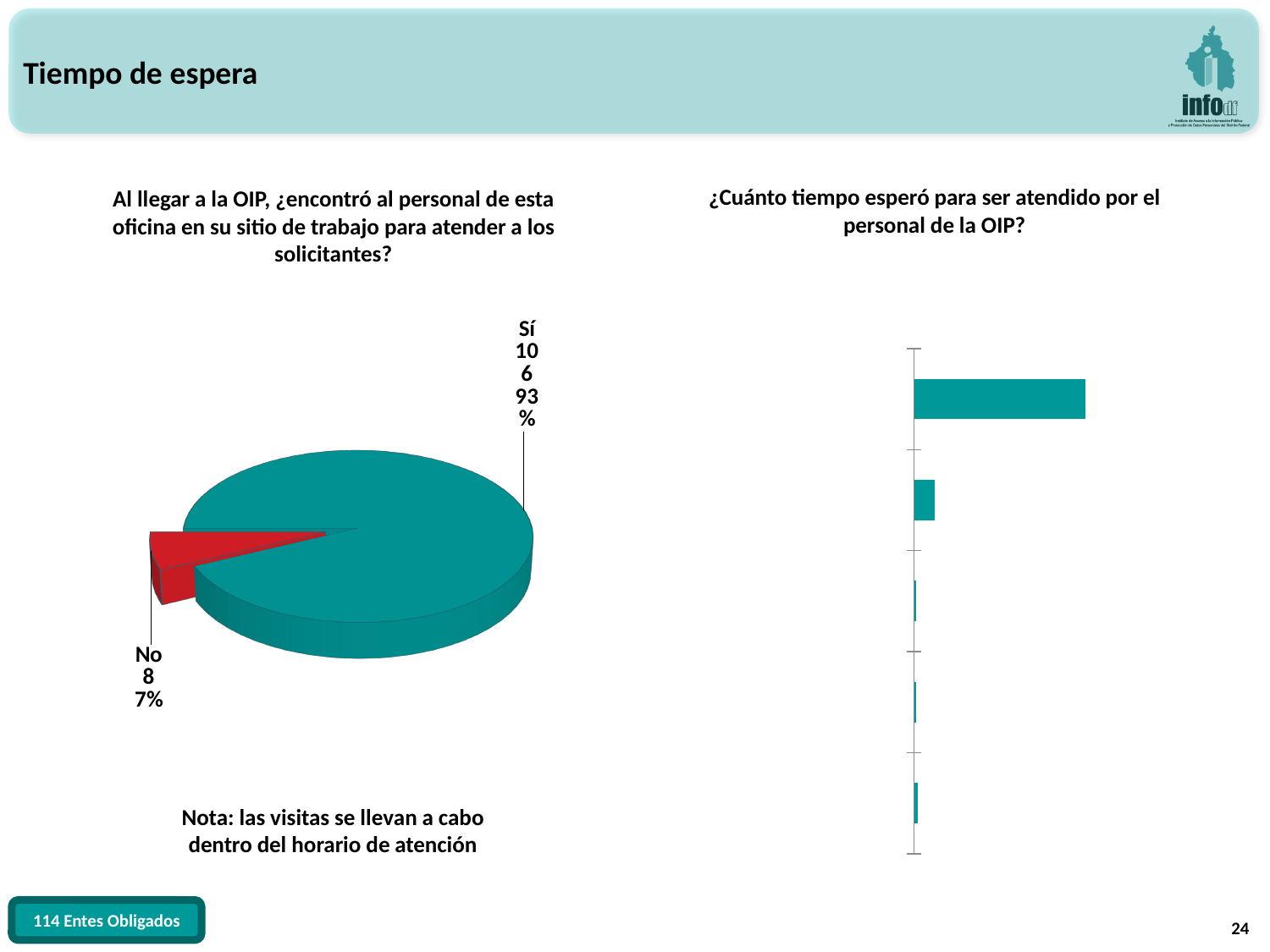
How many categories does the pie chart on the left show? 2 In the pie chart on the left, which category has the largest slice? Sí In the pie chart on the left, what share of the pie does the "Sí" slice represent? 93% In the pie chart on the left, how many respondents answered "No"? 8 In the pie chart on the left, which is larger, the "Sí" count or the "No" count? Sí In the pie chart on the left, which category has the smallest slice? No In the pie chart on the left, what share of the pie does the "No" slice represent? 7% In the pie chart on the left, how many respondents answered "Sí"? 106 What kind of chart is shown on the right side of the slide, under "¿Cuánto tiempo esperó para ser atendido por el personal de la OIP?"? Bar chart What kind of chart is shown on the left side of the slide? Pie chart In the pie chart on the left, what colour is the "No" slice? Red In the pie chart on the left, what is the difference between the number of "Sí" and "No" responses? 98